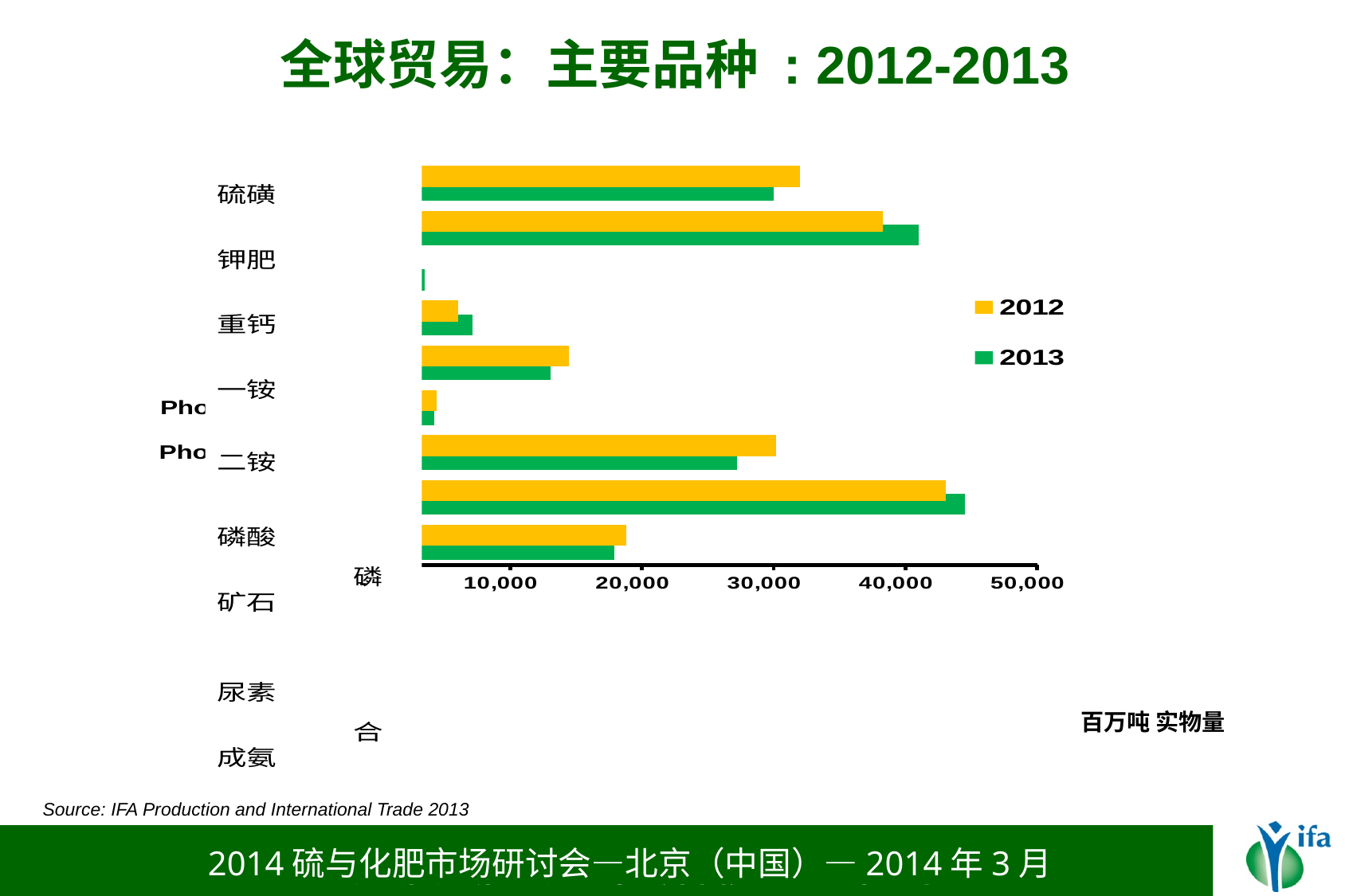
Is the longest 2012 bar in the chart greater or less than 40,000? greater What kind of chart is shown on the slide? bar chart What unit is stated for the values in the chart? 百万吨 实物量 What is the highest value shown on the horizontal axis of the chart? 50,000 Is the longest 2013 bar in the chart greater or less than 40,000? greater Which years are listed in the chart legend? 2012 and 2013 How many category labels are listed along the vertical axis of the chart? 9 How many series does the legend list? 2